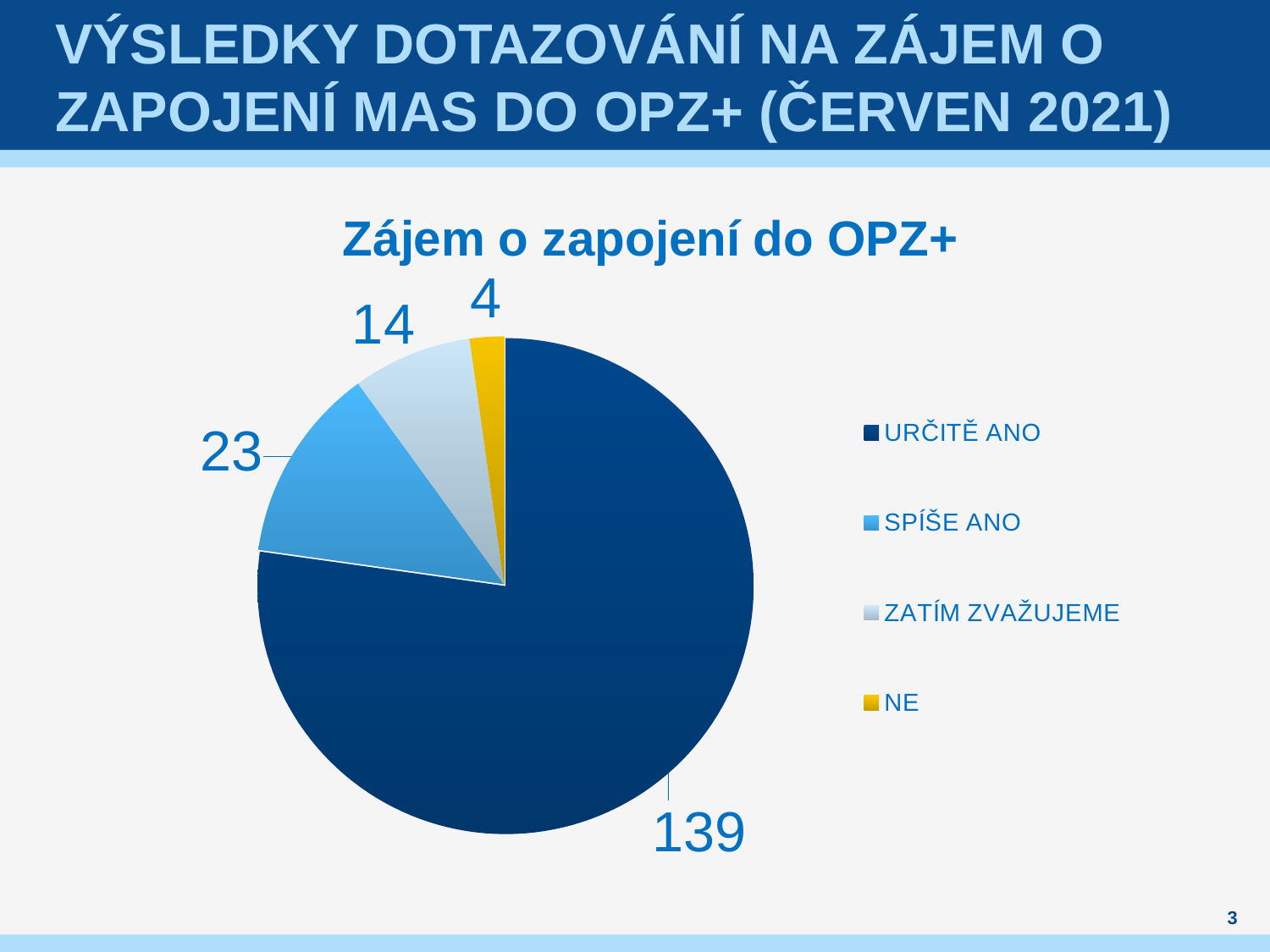
Which is larger, the value for SPÍŠE ANO or the value for ZATÍM ZVAŽUJEME? SPÍŠE ANO What is the value for NE? 4 What colour is the slice for NE? yellow Which category has the smallest slice of the pie? NE Which category has the largest slice of the pie? URČITĚ ANO What is the title of the chart? Zájem o zapojení do OPZ+ What is the value for ZATÍM ZVAŽUJEME? 14 What is the value for SPÍŠE ANO? 23 How many categories does the legend list? 4 What is the difference between the values for URČITĚ ANO and SPÍŠE ANO? 116 What type of chart is shown on the slide? pie chart What is the value for URČITĚ ANO? 139